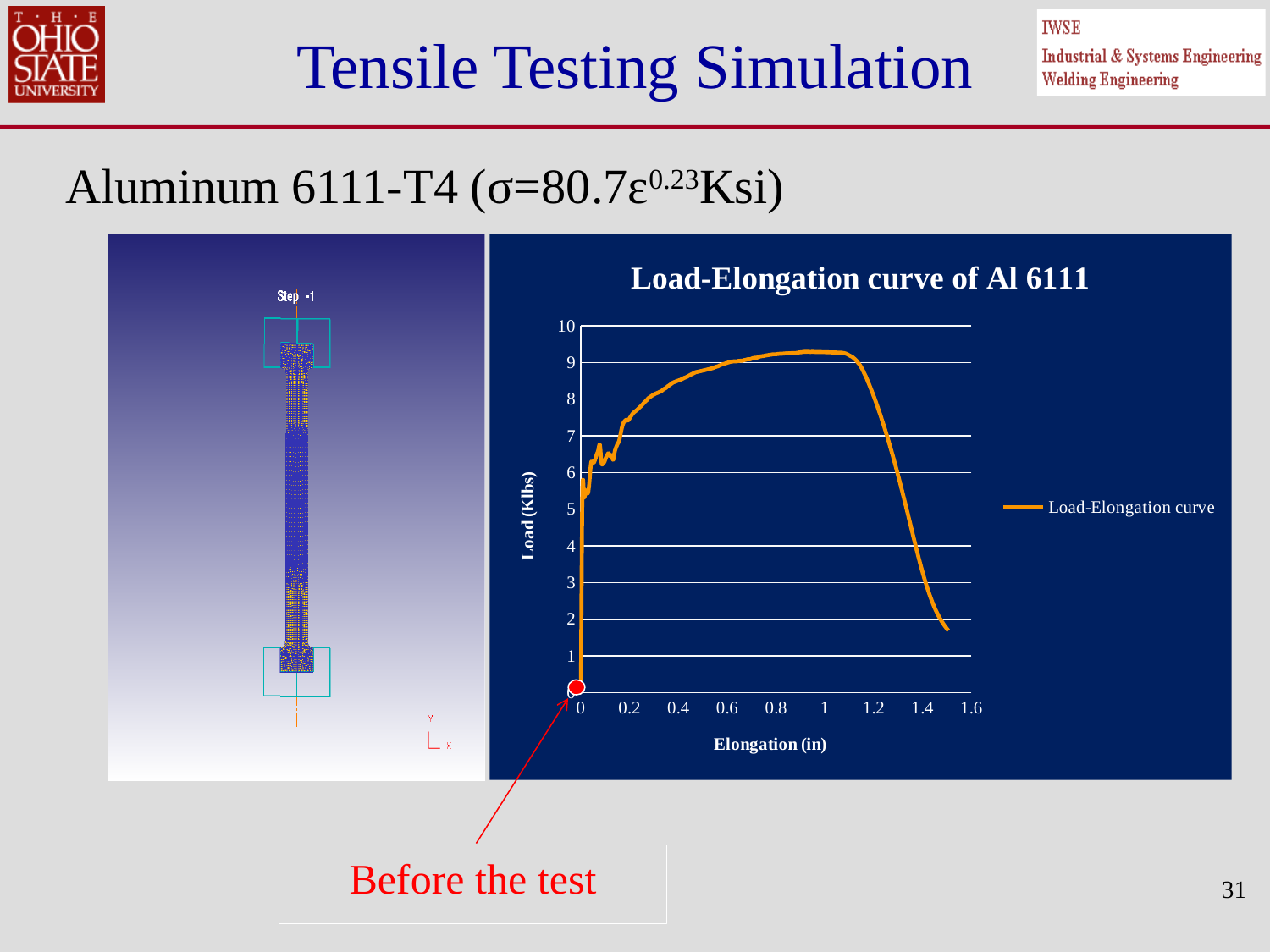
Does the load rise or fall as elongation increases from 0 to 0.8 in? rise Is the load at an elongation of 0.2 in greater or less than 6 Klbs? greater Is the maximum load reached on the curve greater or less than 10 Klbs? less What is the title of the chart on the slide? Load-Elongation curve of Al 6111 Is the load at an elongation of 0.8 in larger or smaller than the load at an elongation of 1.4 in? larger Is the load at an elongation of 1.0 in greater or less than 8 Klbs? greater Does the load rise or fall as elongation increases from 1.2 to 1.4 in? fall What kind of chart is shown on the slide? line chart How many series does the chart legend list? 1 What is the label of the y axis of the chart? Load (Klbs)